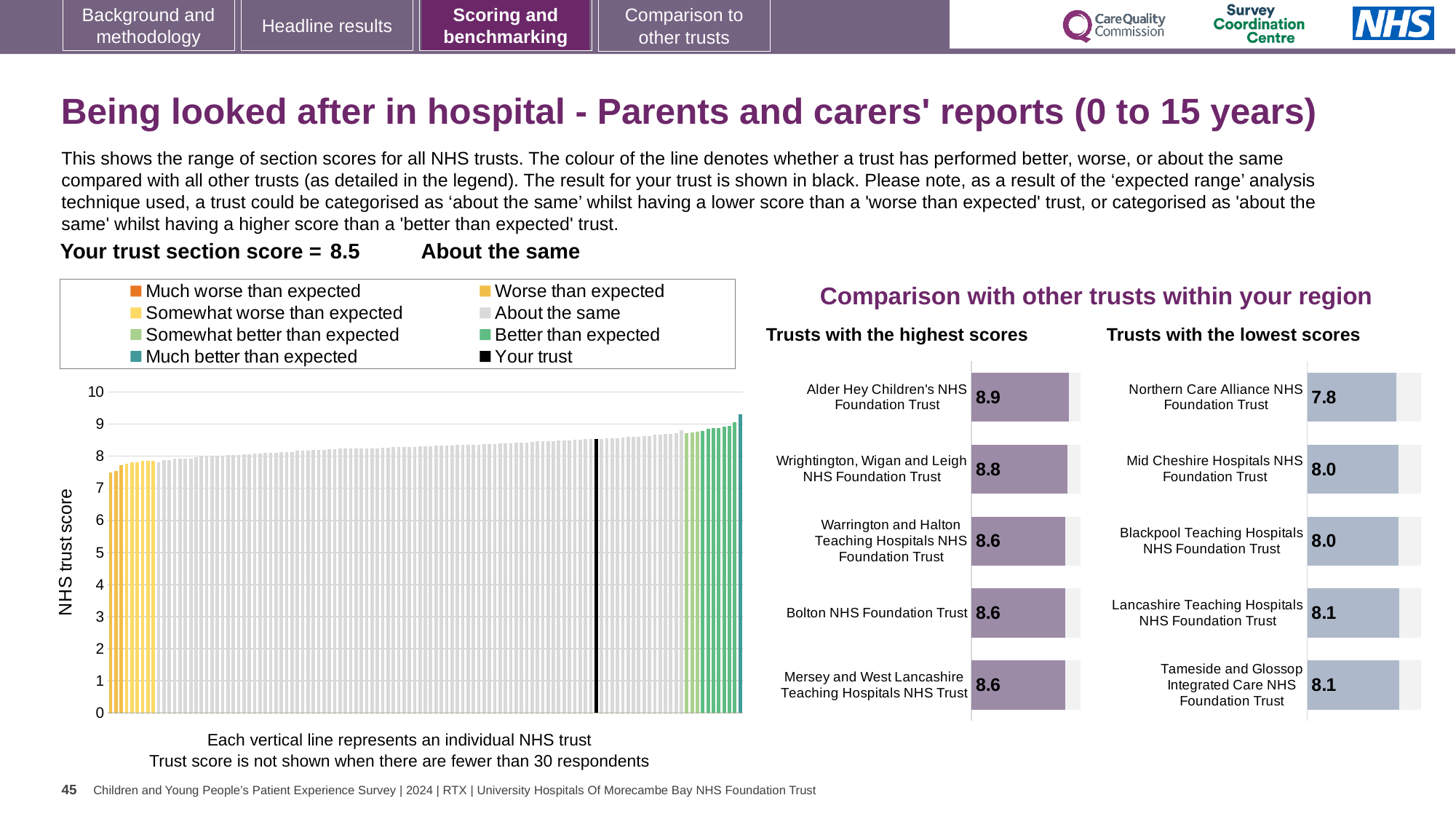
In the 'Trusts with the lowest scores' chart, which has the larger score: Lancashire Teaching Hospitals NHS Foundation Trust or Northern Care Alliance NHS Foundation Trust? Lancashire Teaching Hospitals NHS Foundation Trust In the 'Trusts with the highest scores' chart, what is the score for Alder Hey Children's NHS Foundation Trust? 8.9 In the 'Trusts with the highest scores' chart, what is the score for Wrightington, Wigan and Leigh NHS Foundation Trust? 8.8 In the 'Trusts with the lowest scores' chart, what is the score for Northern Care Alliance NHS Foundation Trust? 7.8 In the large 'NHS trust score' chart on the left, is the value for your trust (the black line) greater or less than 8? greater In the 'Trusts with the lowest scores' chart, which trust has the lowest score? Northern Care Alliance NHS Foundation Trust In the 'Trusts with the highest scores' chart, which trust has the highest score? Alder Hey Children's NHS Foundation Trust How many trusts are listed in the 'Trusts with the highest scores' chart? 5 How many entries does the legend of the large 'NHS trust score' chart on the left list? 8 In the 'Trusts with the highest scores' chart, what is the difference between the scores of Alder Hey Children's NHS Foundation Trust and Wrightington, Wigan and Leigh NHS Foundation Trust? 0.1 In the 'Trusts with the lowest scores' chart, what is the score for Lancashire Teaching Hospitals NHS Foundation Trust? 8.1 In the 'Trusts with the lowest scores' chart, what is the difference between the scores of Tameside and Glossop Integrated Care NHS Foundation Trust and Northern Care Alliance NHS Foundation Trust? 0.3